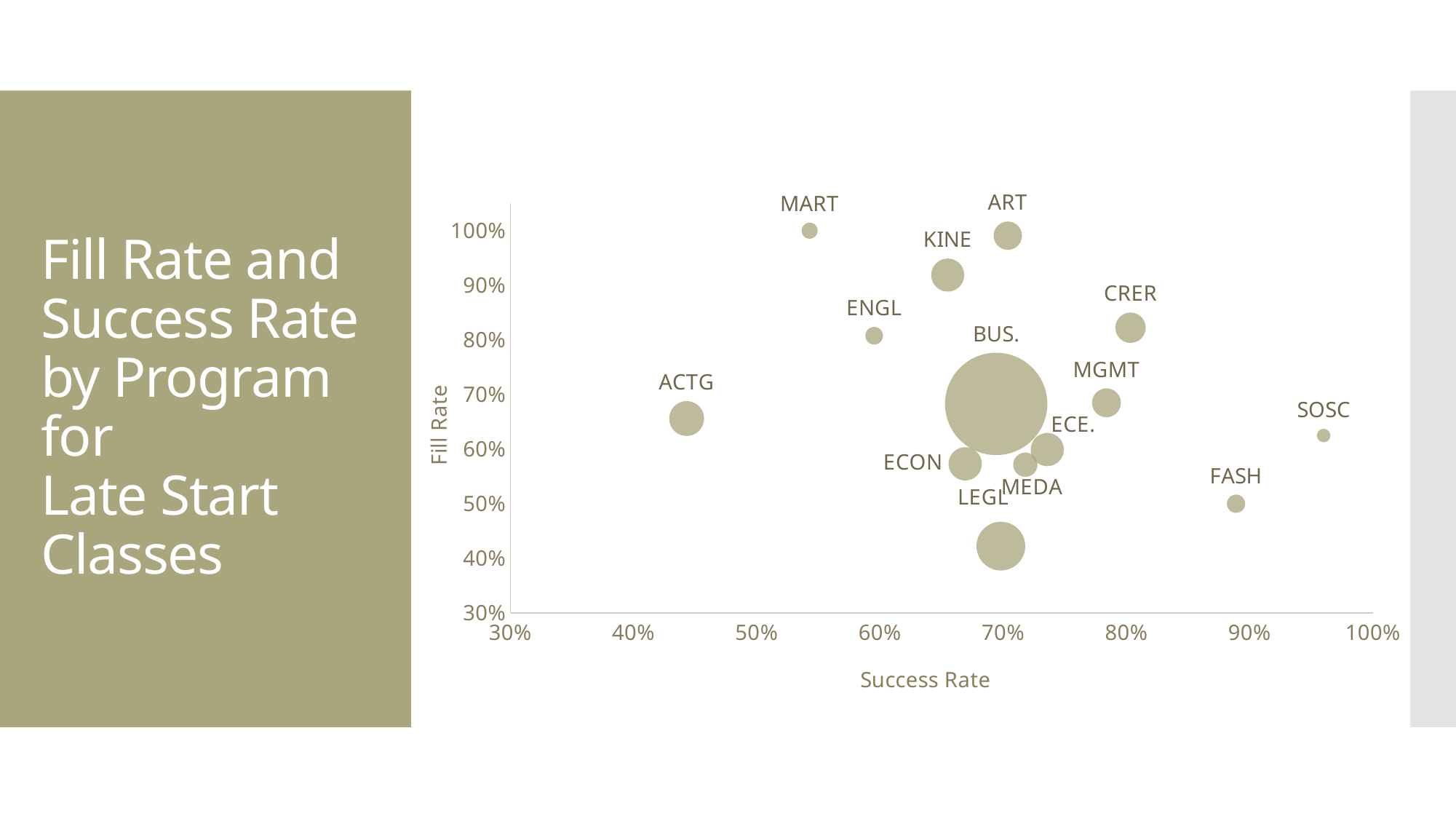
Is the fill rate for BUS. greater or less than 80%? less What is the title of the horizontal axis? Success Rate Is the fill rate for LEGL greater or less than 50%? less Is the success rate for SOSC greater or less than 90%? greater Which program has a higher fill rate, KINE or ENGL? KINE Which program has the highest success rate? SOSC Which program has a higher success rate, ACTG or FASH? FASH Which program has the lowest fill rate? LEGL What kind of chart is shown on the slide? Bubble chart Which program has the lowest success rate? ACTG How many programs are plotted as labeled bubbles on the chart? 14